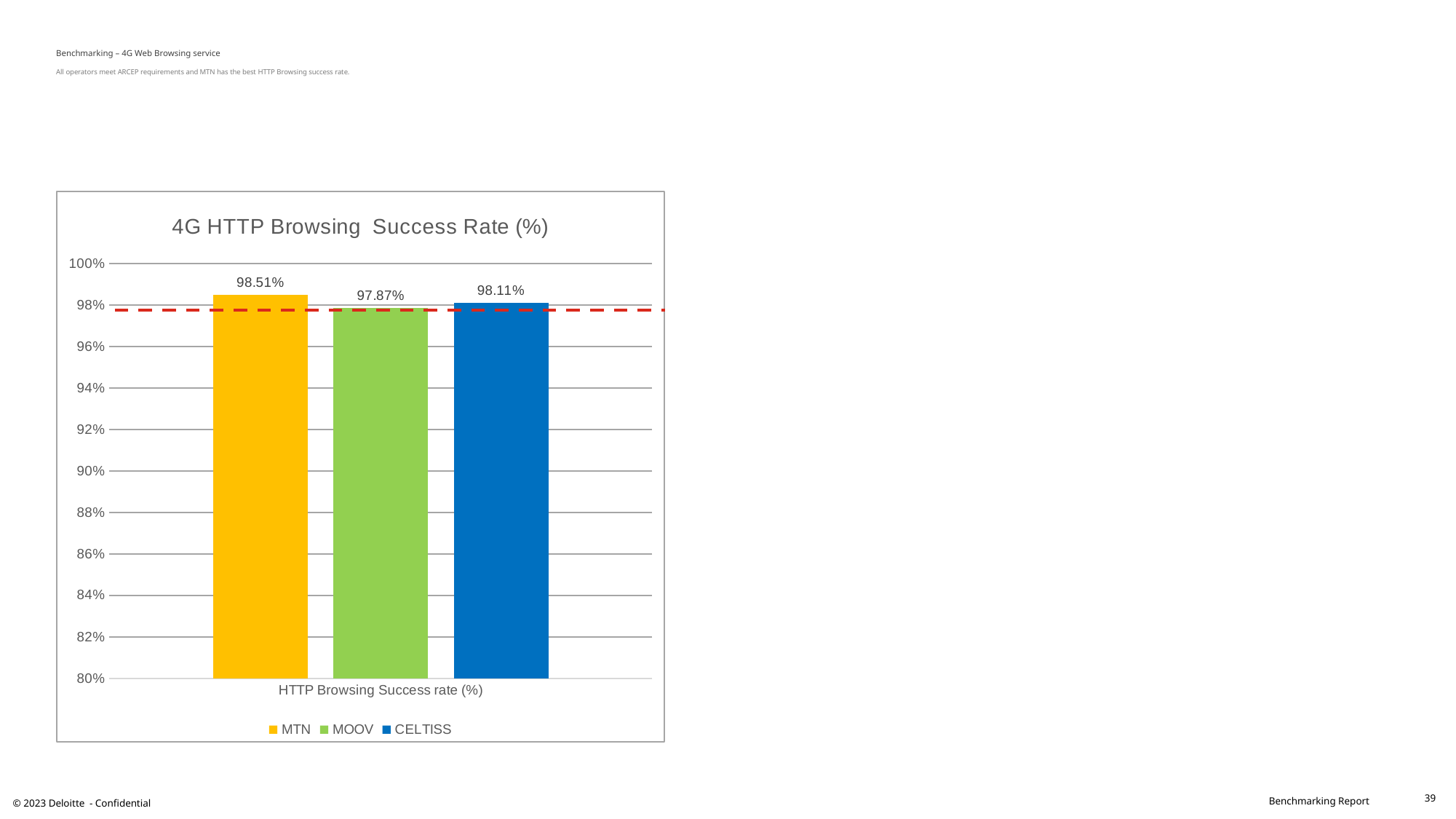
How many series does the legend list? 3 What is the 4G HTTP Browsing success rate for MOOV? 97.87% Which operator has the lowest 4G HTTP Browsing success rate? MOOV What is the 4G HTTP Browsing success rate for CELTISS? 98.11% What kind of chart is shown on the slide? Bar chart What is the 4G HTTP Browsing success rate for MTN? 98.51% Is the value for MOOV greater or less than 98%? less Which has a higher HTTP Browsing success rate, CELTISS or MOOV? CELTISS What is the difference in percentage points between MTN's and MOOV's HTTP Browsing success rates? 0.64% What is the difference in percentage points between CELTISS's and MOOV's HTTP Browsing success rates? 0.24% What is the title of the chart? 4G HTTP Browsing Success Rate (%) Which operator has the highest 4G HTTP Browsing success rate? MTN